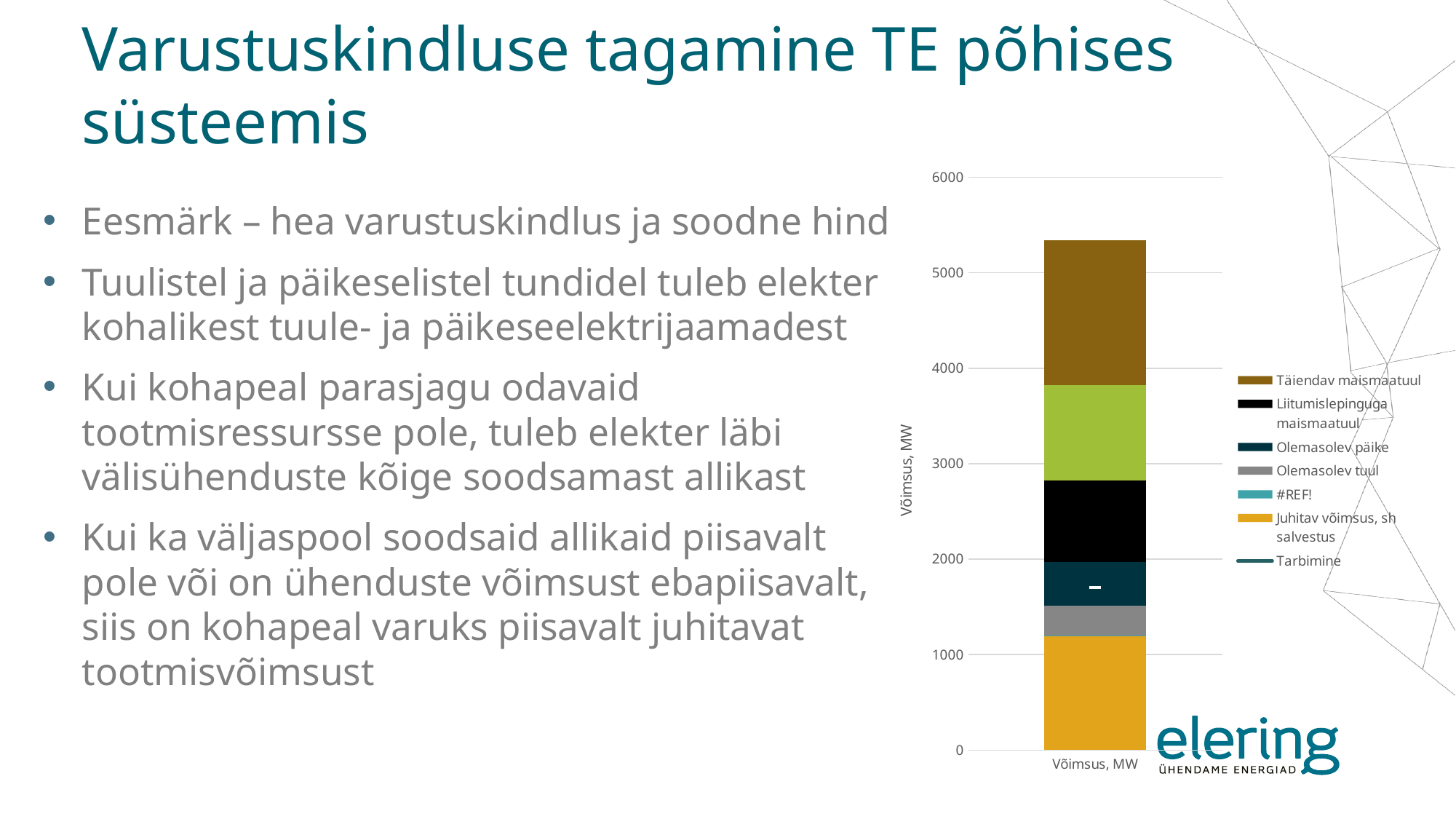
Is the total height of the stacked bar greater or less than 6000? less Which segment is larger, Täiendav maismaatuul or Olemasolev päike? Täiendav maismaatuul What kind of chart is shown on the slide? Stacked bar chart Which segment is larger, Juhitav võimsus, sh salvestus or Olemasolev tuul? Juhitav võimsus, sh salvestus Is the total height of the stacked bar greater or less than 5000? greater How many bars (categories) are plotted on the x axis? 1 What is the title of the vertical axis? Võimsus, MW Which series forms the bottom segment of the stacked bar? Juhitav võimsus, sh salvestus What is the label of the single category on the x axis? Võimsus, MW How many series does the chart legend list? 7 Which segment of the stacked bar is the largest? Täiendav maismaatuul Which series forms the top segment of the stacked bar? Täiendav maismaatuul